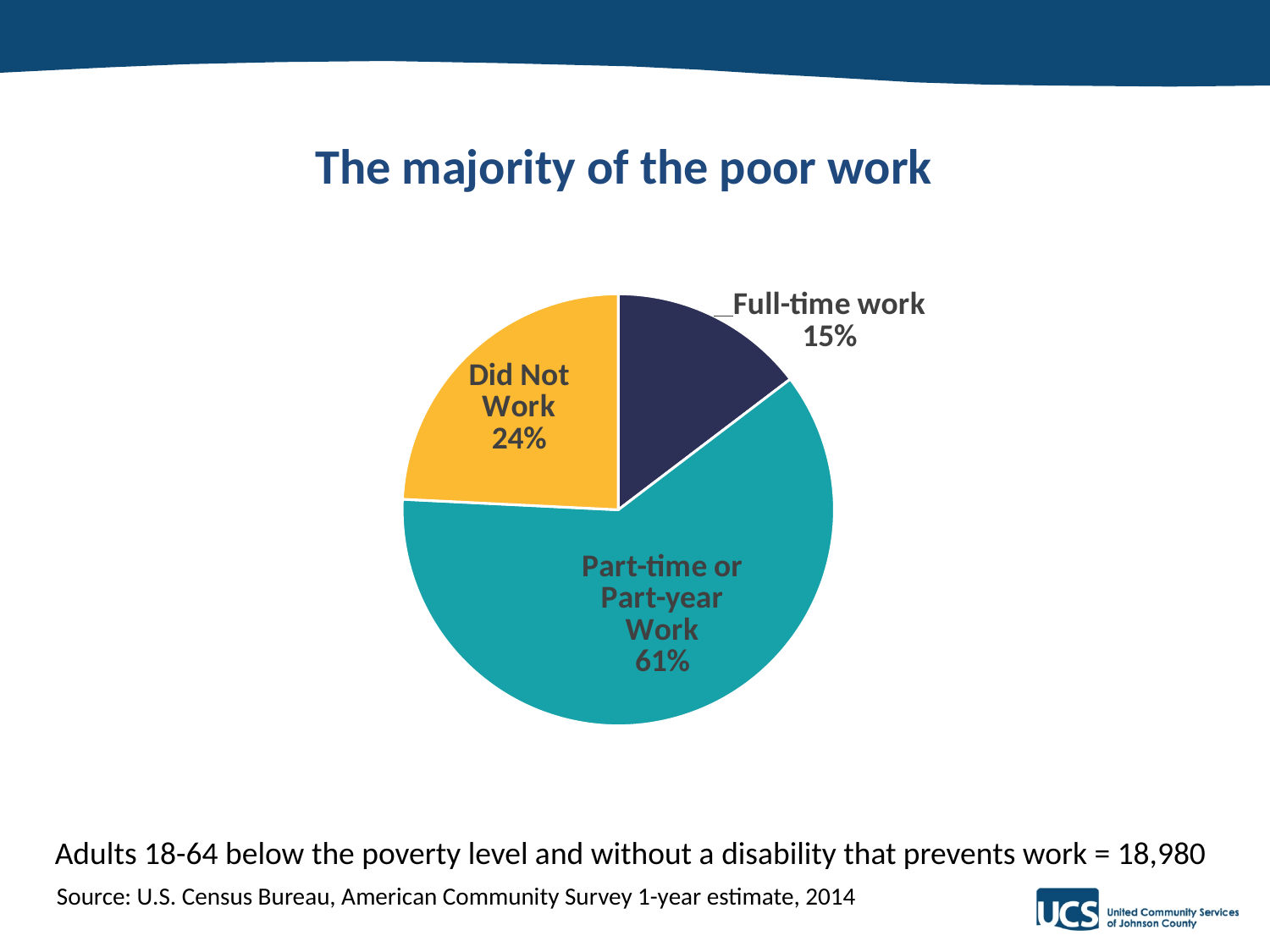
How many slices does the pie chart have? 3 What share of the pie is labelled Full-time work? 15% What kind of chart is shown on the slide? pie chart What share of the pie is labelled Part-time or Part-year Work? 61% What is the difference in percentage points between the Did Not Work slice and the Full-time work slice? 9 Which is larger, the Did Not Work slice or the Full-time work slice? Did Not Work What is the difference in percentage points between the Part-time or Part-year Work slice and the Did Not Work slice? 37 What is the combined share of the Full-time work and Part-time or Part-year Work slices? 76% Which slice of the pie is the smallest? Full-time work What is the title of the slide containing the pie chart? The majority of the poor work What share of the pie is labelled Did Not Work? 24% Which slice of the pie is the largest? Part-time or Part-year Work